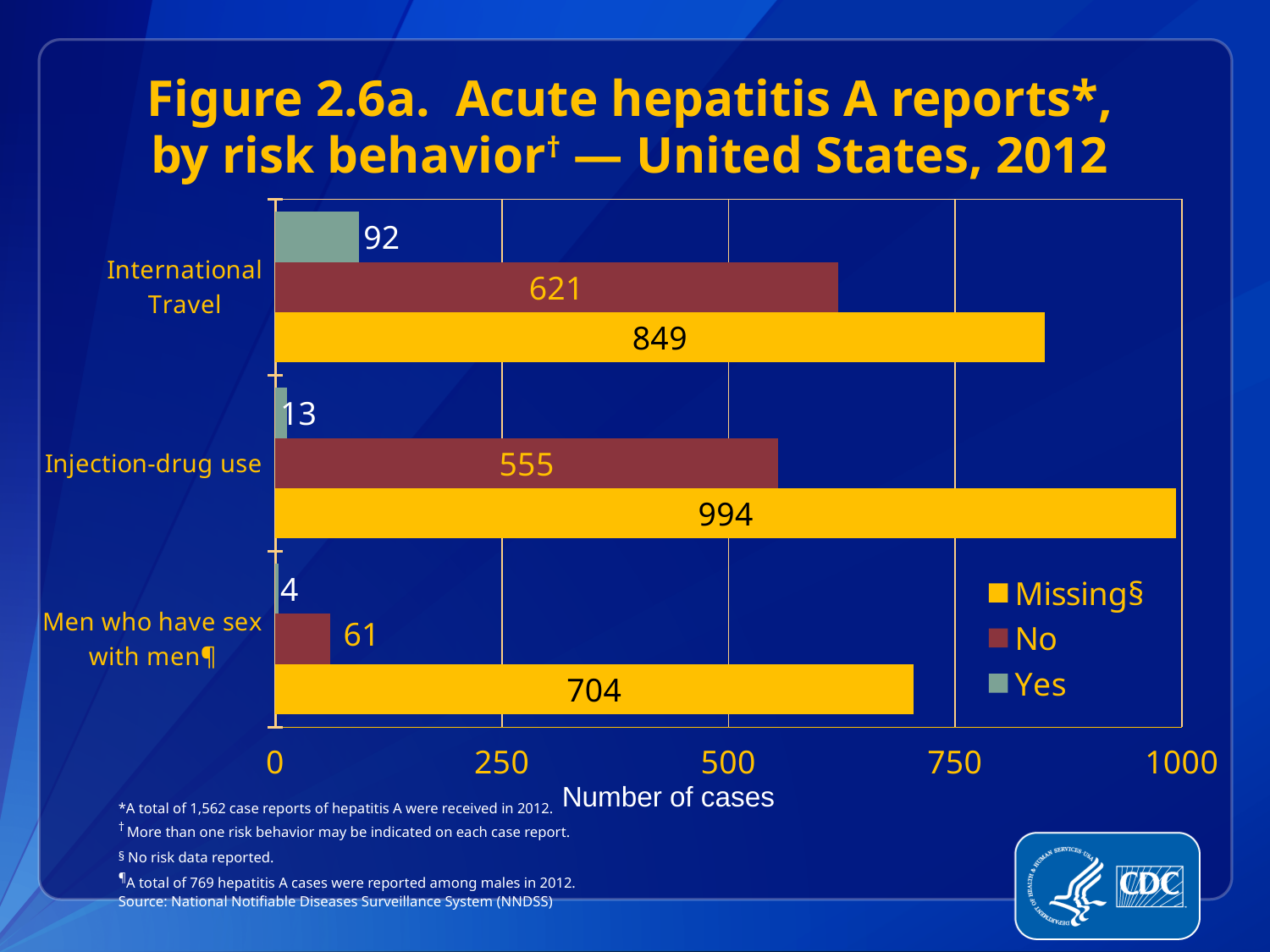
What is the number of cases for 'Yes' in the International Travel category? 92 Which risk behavior category has the lowest 'Yes' value? Men who have sex with men Which is larger: the 'Yes' value for International Travel or the 'Yes' value for Injection-drug use? International Travel Which risk behavior category has the highest 'Missing' value? Injection-drug use How many risk behavior categories are shown on the chart? 3 What is the label of the x axis? Number of cases What is the difference between the 'No' values for International Travel and Injection-drug use? 66 What is the number of cases for 'Missing' in the Injection-drug use category? 994 What kind of chart is shown on the slide? bar chart Is the 'Missing' value for Men who have sex with men greater or less than 750? less How many series does the legend list? 3 What is the number of cases for 'No' in the Men who have sex with men category? 61